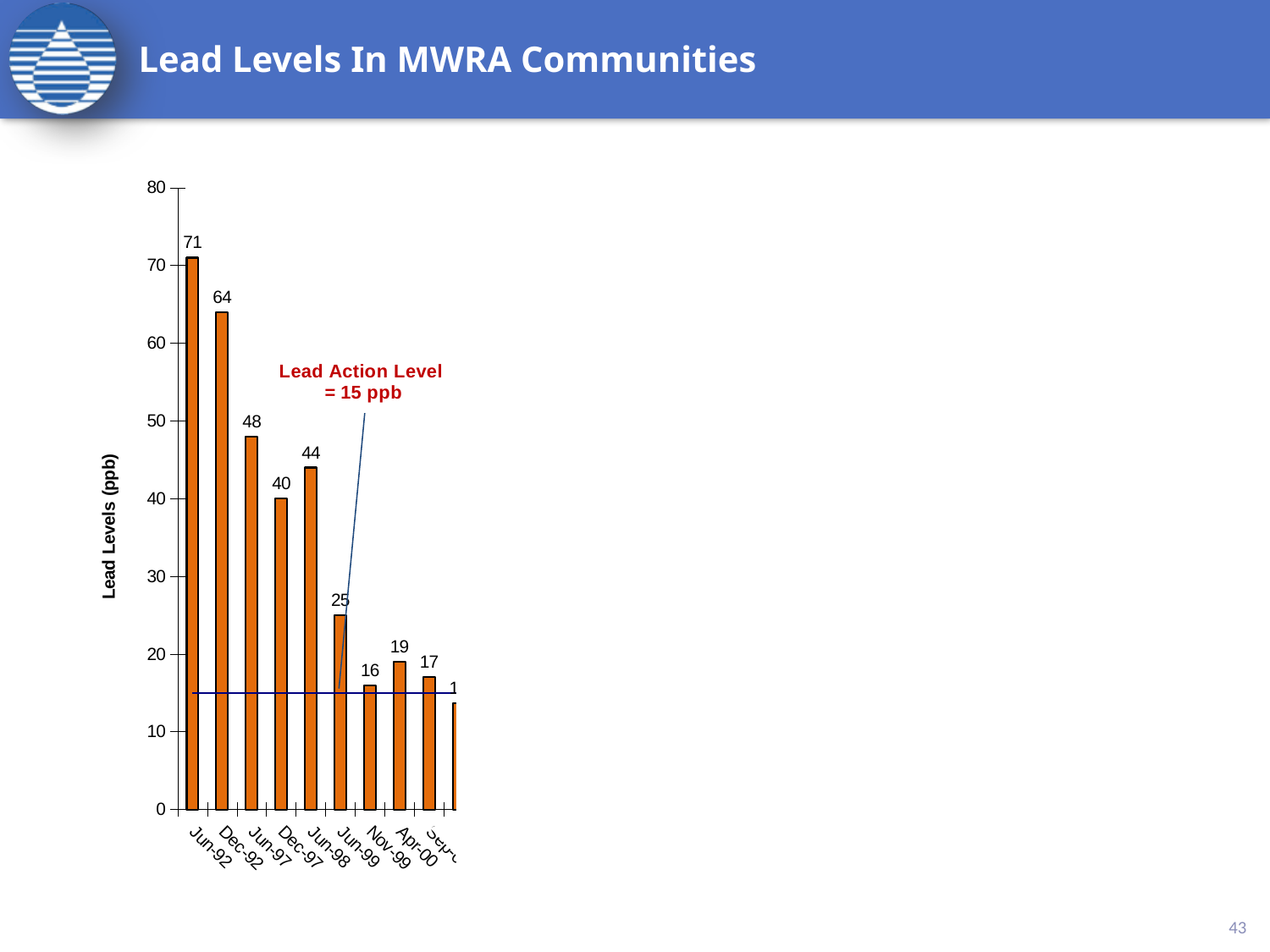
What is the lead level for Jun-97? 48 What is the lead level for Jun-98? 44 Which is larger, the lead level for Dec-97 or for Jun-98? Jun-98 Do the lead levels generally rise or fall from Jun-92 to Apr-00? Fall What is the lead level for Jun-99? 25 What is the lead level for Jun-92? 71 What is the lead level for Dec-92? 64 What value does the Lead Action Level line on the chart represent? 15 ppb What is the lead level for Dec-97? 40 What is the difference between the lead levels for Jun-92 and Dec-92? 7 What kind of chart is shown on the slide? Bar chart Which period has the highest lead level? Jun-92